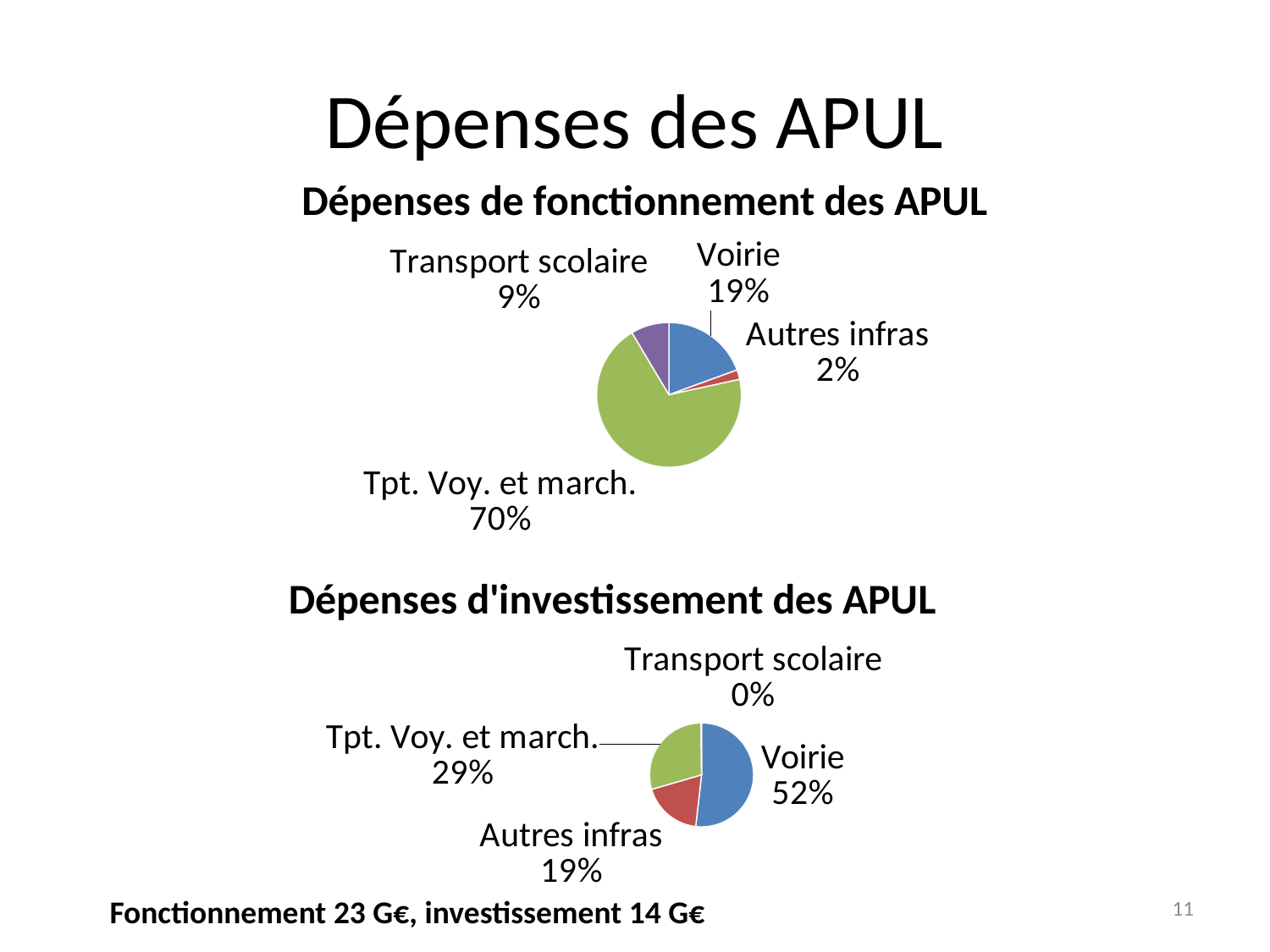
In the 'Dépenses de fonctionnement des APUL' chart, what share does 'Voirie' have? 19% In the 'Dépenses de fonctionnement des APUL' chart, what is the difference between the shares of 'Voirie' and 'Transport scolaire'? 10 percentage points In the 'Dépenses de fonctionnement des APUL' chart, what share does 'Tpt. Voy. et march.' have? 70% In the 'Dépenses d'investissement des APUL' chart, which is larger, 'Tpt. Voy. et march.' or 'Autres infras'? Tpt. Voy. et march. In the 'Dépenses d'investissement des APUL' chart, what share does 'Transport scolaire' have? 0% In the 'Dépenses de fonctionnement des APUL' chart, which category has the smallest share? Autres infras In the 'Dépenses d'investissement des APUL' chart, what share does 'Autres infras' have? 19% In the 'Dépenses de fonctionnement des APUL' chart, which category has the largest share? Tpt. Voy. et march. What kind of chart is 'Dépenses de fonctionnement des APUL'? Pie chart How many categories are labelled in the 'Dépenses d'investissement des APUL' chart? 4 In the 'Dépenses d'investissement des APUL' chart, what share does 'Voirie' have? 52% In the 'Dépenses d'investissement des APUL' chart, what is the difference between the shares of 'Voirie' and 'Tpt. Voy. et march.'? 23 percentage points